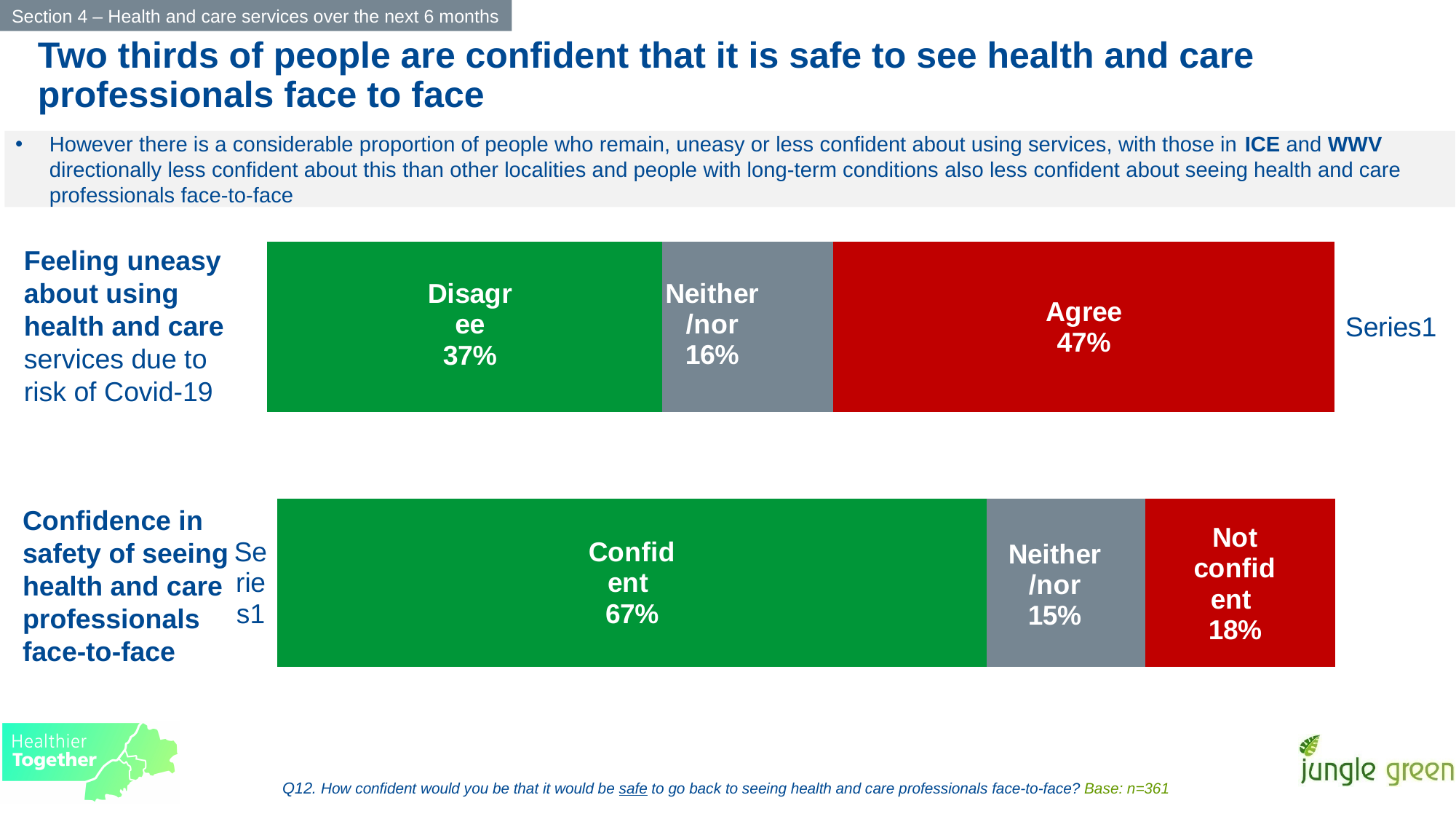
How many segments make up the bar in the bottom chart (confidence in safety of seeing professionals face-to-face)? 3 In the bottom chart (confidence in safety of seeing professionals face-to-face), what percentage of people are not confident? 18% In the bottom chart (confidence in safety of seeing professionals face-to-face), what percentage of people are confident? 67% In the top chart (feeling uneasy about using health and care services), which is larger: Agree or Disagree? Agree In the top chart (feeling uneasy about using health and care services), what percentage of people disagree? 37% In the bottom chart (confidence in safety of seeing professionals face-to-face), which segment is the largest? Confident In the top chart (feeling uneasy about using health and care services), which segment is the smallest? Neither/nor In the top chart (feeling uneasy about using health and care services), what is the Neither/nor percentage? 16% In the bottom chart (confidence in safety of seeing professionals face-to-face), what is the difference between the Confident and Not confident percentages? 49% In the top chart (feeling uneasy about using health and care services), what percentage of people agree? 47% In the top chart (feeling uneasy about using health and care services), what is the difference between the Agree and Disagree percentages? 10% What type of chart is used for the top chart (feeling uneasy about using health and care services)? Stacked bar chart